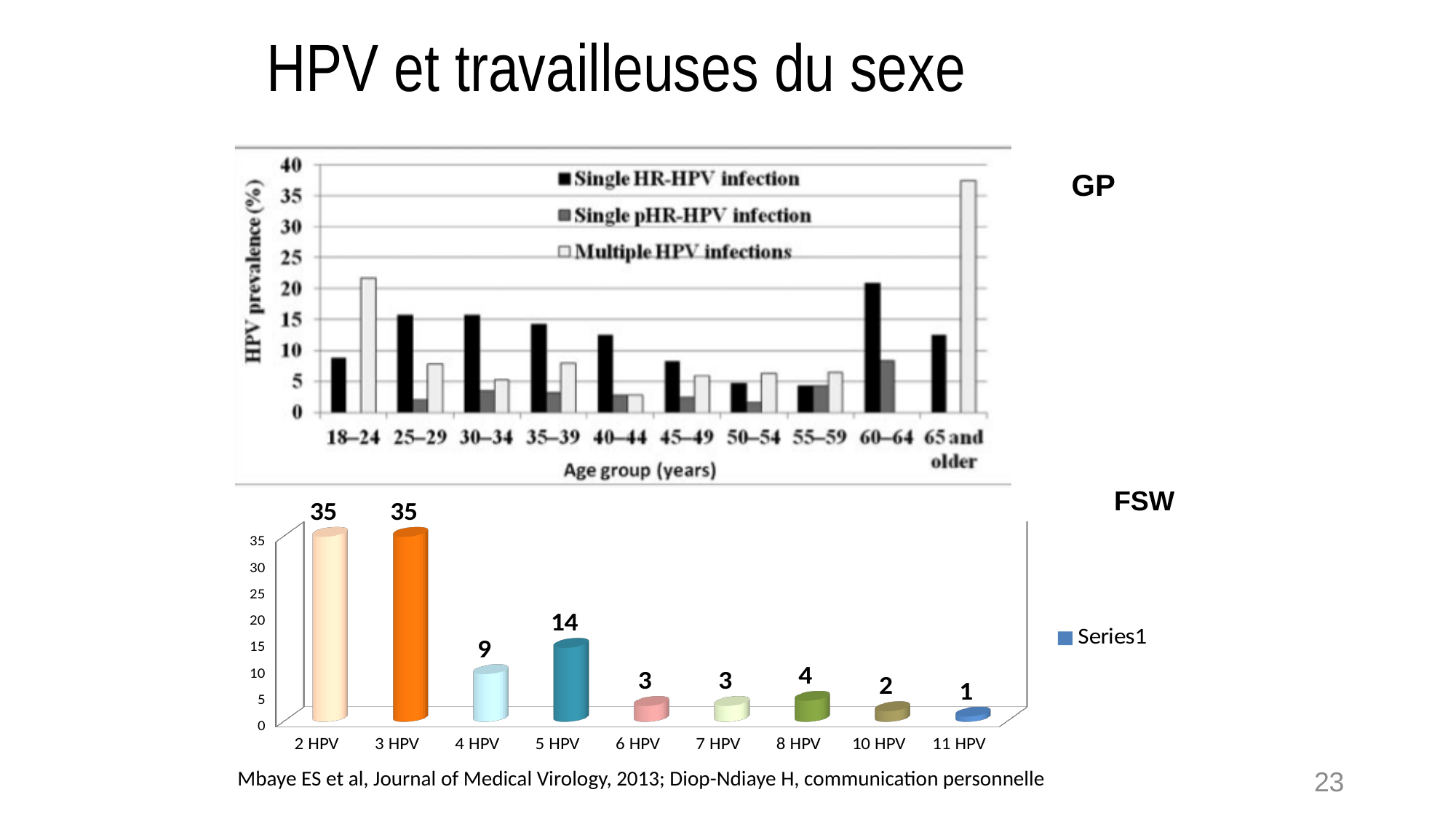
In the top chart (GP), is the Single HR-HPV infection value for the 50–54 group greater or less than 10? less In the bottom chart (FSW), what is the value for 5 HPV? 14 How many categories are shown in the bottom chart (FSW)? 9 How many age groups are shown on the x axis of the top chart (GP)? 10 In the bottom chart (FSW), what is the only entry listed in the legend? Series1 In the bottom chart (FSW), which is larger, the value for 8 HPV or the value for 10 HPV? 8 HPV In the bottom chart (FSW), which category has the lowest value? 11 HPV How many series does the legend of the top chart (GP) list? 3 What kind of chart is the bottom chart (FSW)? Bar chart In the bottom chart (FSW), what is the value for 4 HPV? 9 In the top chart (GP), is the Multiple HPV infections value for the 65 and older group greater or less than 30? greater In the bottom chart (FSW), what is the difference between the values for 5 HPV and 4 HPV? 5